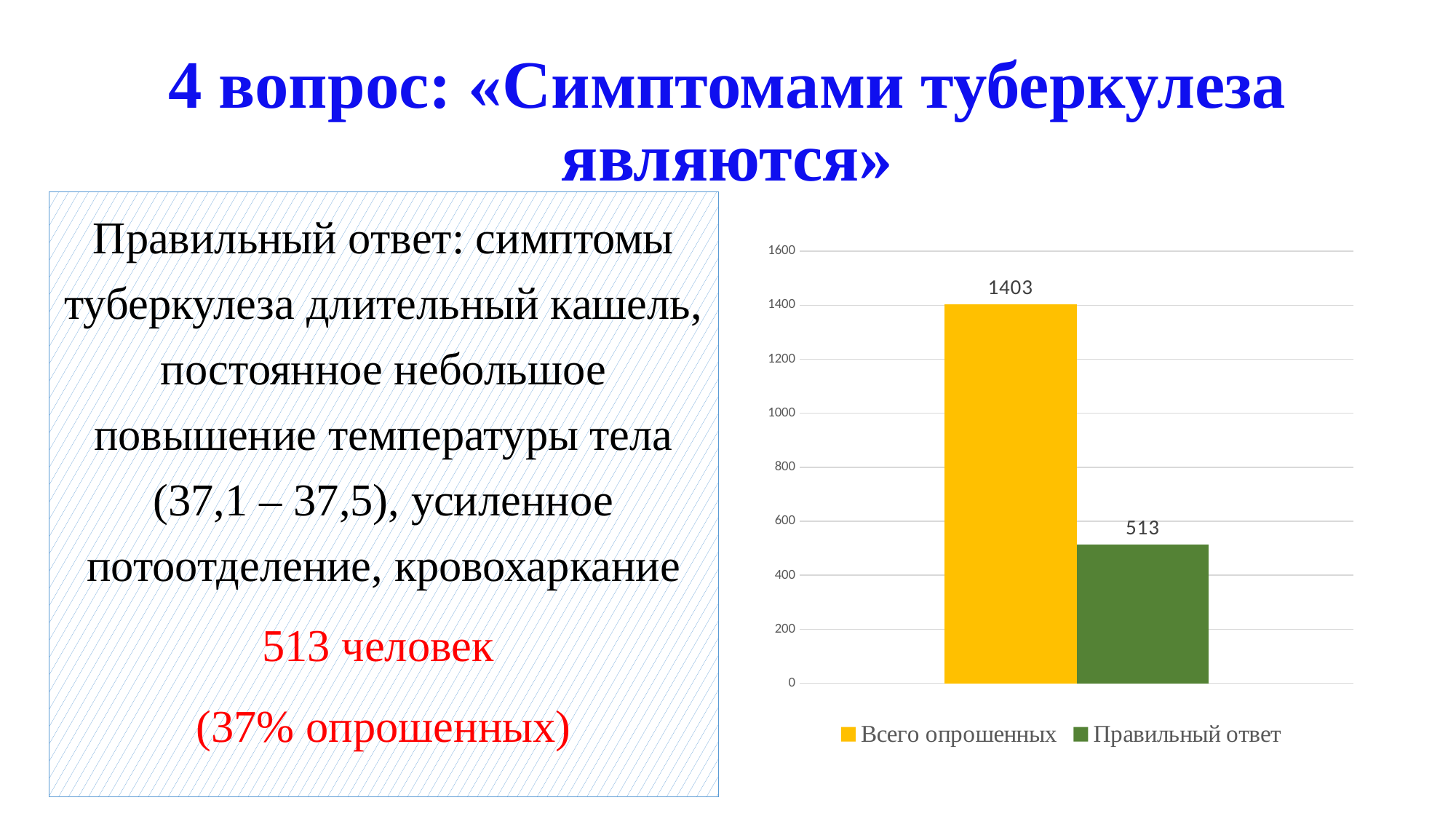
What is the value for Правильный ответ? 513 Is the value for Всего опрошенных greater or less than 1200? greater What is the difference between Всего опрошенных and Правильный ответ? 890 How many series does the legend list? 2 What is the highest value shown on the vertical axis? 1600 What colour is the bar for Всего опрошенных? yellow How many bars are plotted in the chart? 2 Is the value for Правильный ответ greater or less than 600? less What kind of chart is shown on the slide? bar chart Which series has the lowest value? Правильный ответ What is the value for Всего опрошенных? 1403 Which series has the higher value, Всего опрошенных or Правильный ответ? Всего опрошенных